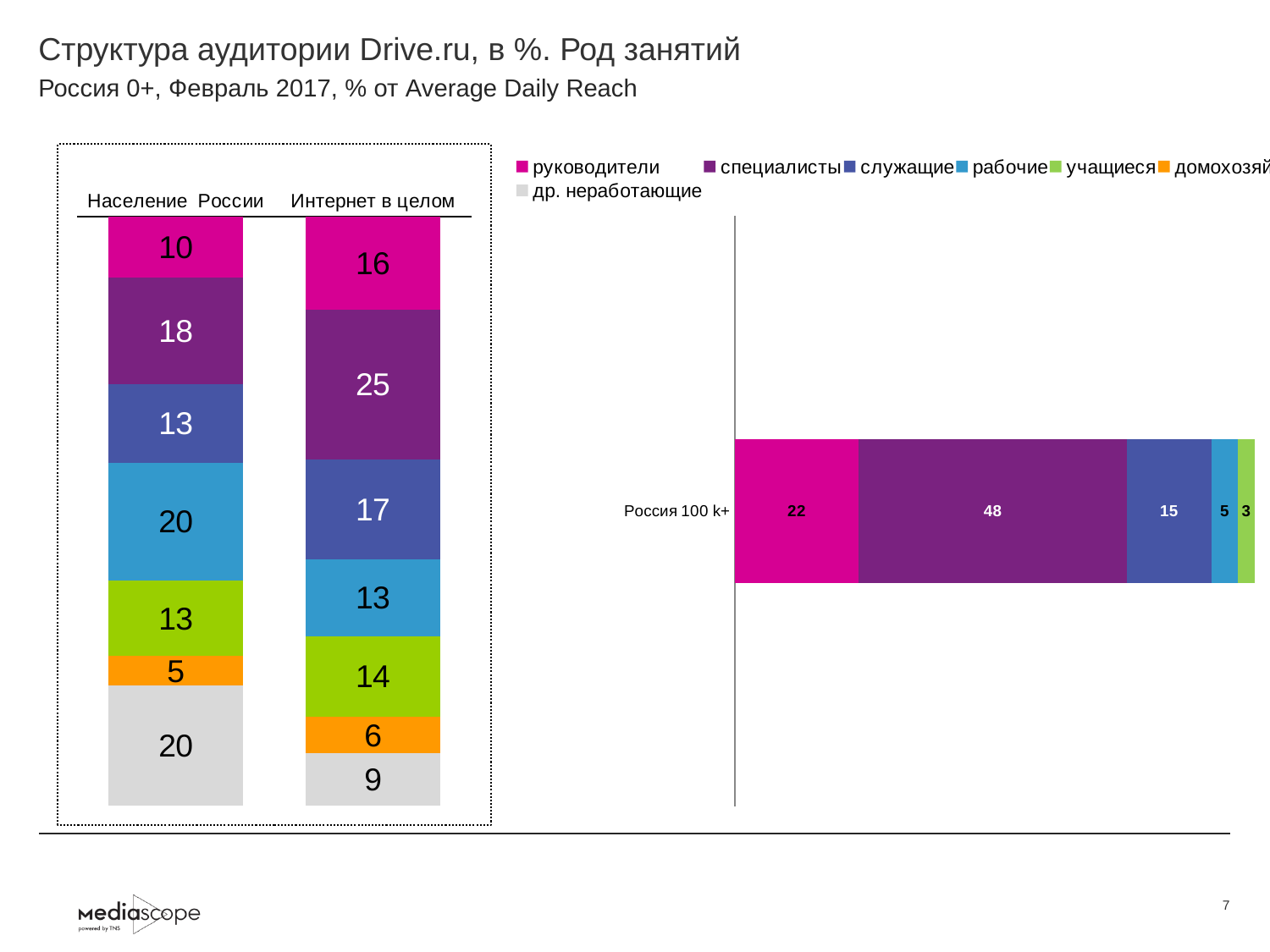
What kind of chart is shown on the right side of the slide? stacked bar chart In the left chart, what is the value for руководители in the Интернет в целом bar? 16 In the right chart (Россия 100 k+), what is the value for специалисты? 48 In the right chart (Россия 100 k+), what is the value for служащие? 15 In the left chart, which occupation group has the smallest value in the Население России bar? домохозяйки In the left chart, what is the difference between специалисты in Интернет в целом and специалисты in Население России? 7 In the left chart, what is the value for др. неработающие in the Население России bar? 20 In the left chart, which occupation group has the largest value in the Интернет в целом bar? специалисты How many series does the legend list? 7 In the left chart, what is the value for специалисты in the Население России bar? 18 In the right chart (Россия 100 k+), what is the value for руководители? 22 In the left chart, which is larger: рабочие in Население России or рабочие in Интернет в целом? Население России